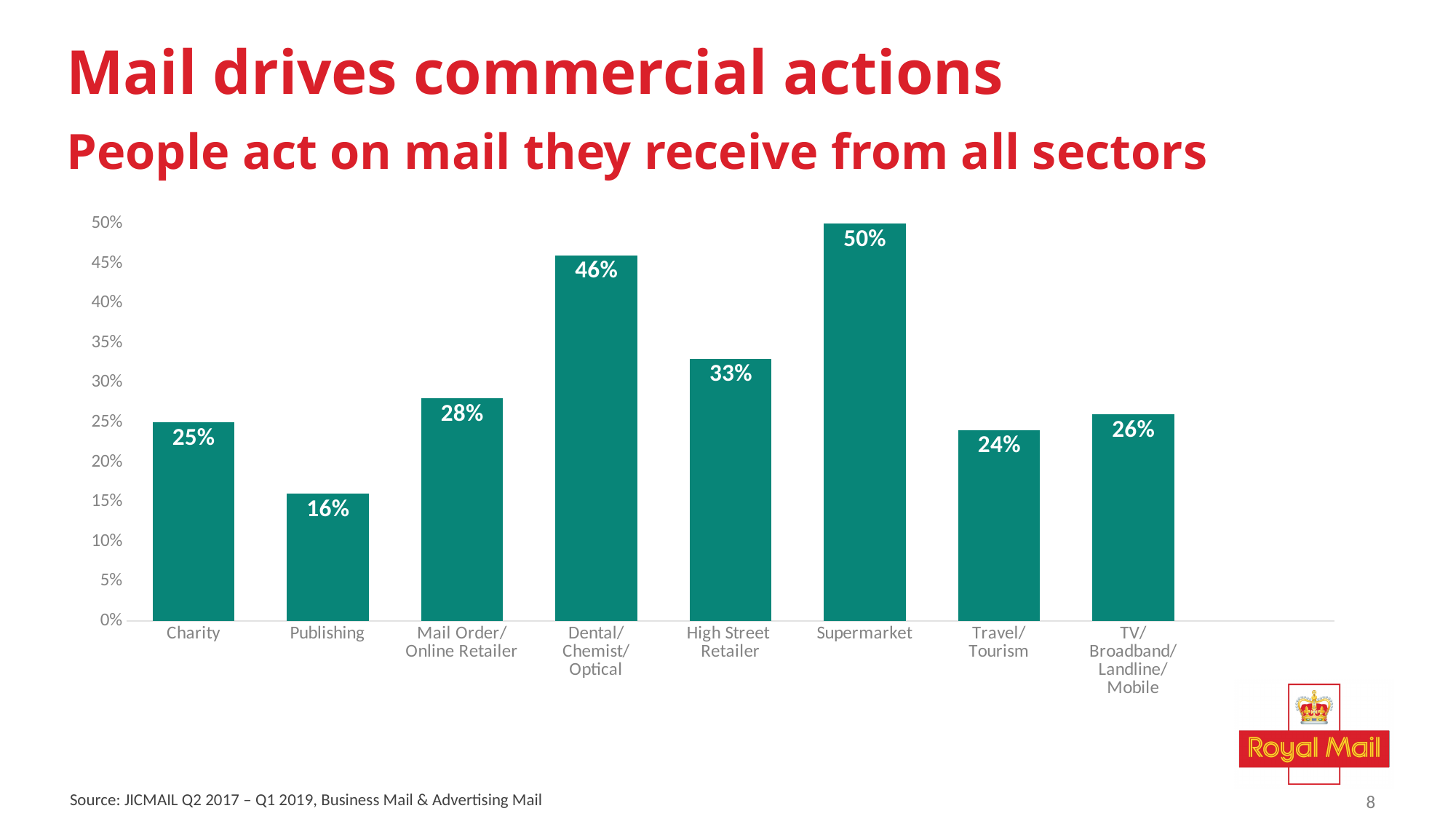
Which category has the highest value? Supermarket What is the value for Supermarket? 50% What is the difference between the values for Dental/Chemist/Optical and High Street Retailer? 13% What is the difference between the values for Supermarket and Publishing? 34% What kind of chart is shown on the slide? Bar chart What is the source cited at the bottom of the slide? JICMAIL Q2 2017 – Q1 2019, Business Mail & Advertising Mail What is the value for Dental/Chemist/Optical? 46% Which is larger, the value for Mail Order/Online Retailer or the value for TV/Broadband/Landline/Mobile? Mail Order/Online Retailer What is the value for Travel/Tourism? 24% How many categories are shown on the x axis? 8 What is the value for Publishing? 16% Which category has the lowest value? Publishing